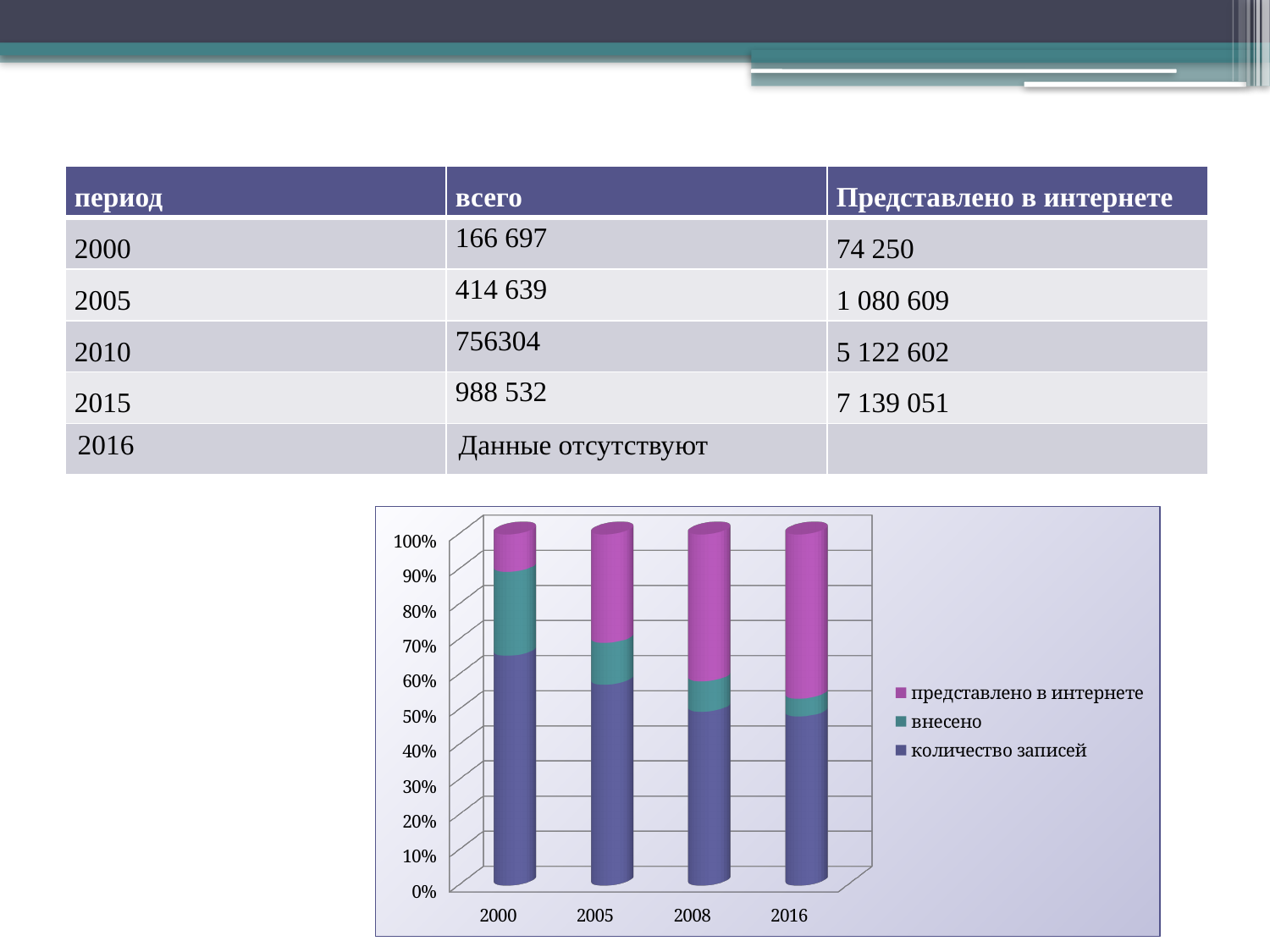
In which year is the share of "представлено в интернете" the largest? 2016 Does the share of "представлено в интернете" rise or fall from 2000 to 2016? Rise Is the share of "количество записей" for 2000 greater or less than 60%? greater How many categories are shown on the x axis of the chart? 4 Which year has the larger share of "внесено": 2000 or 2016? 2000 What kind of chart is shown on the slide? Stacked bar chart In which year is the share of "представлено в интернете" the smallest? 2000 Does the share of "количество записей" rise or fall from 2000 to 2016? Fall Which years are shown on the x axis of the chart? 2000, 2005, 2008, 2016 How many series does the chart legend list? 3 Which series is shown in pink/magenta in the chart? представлено в интернете